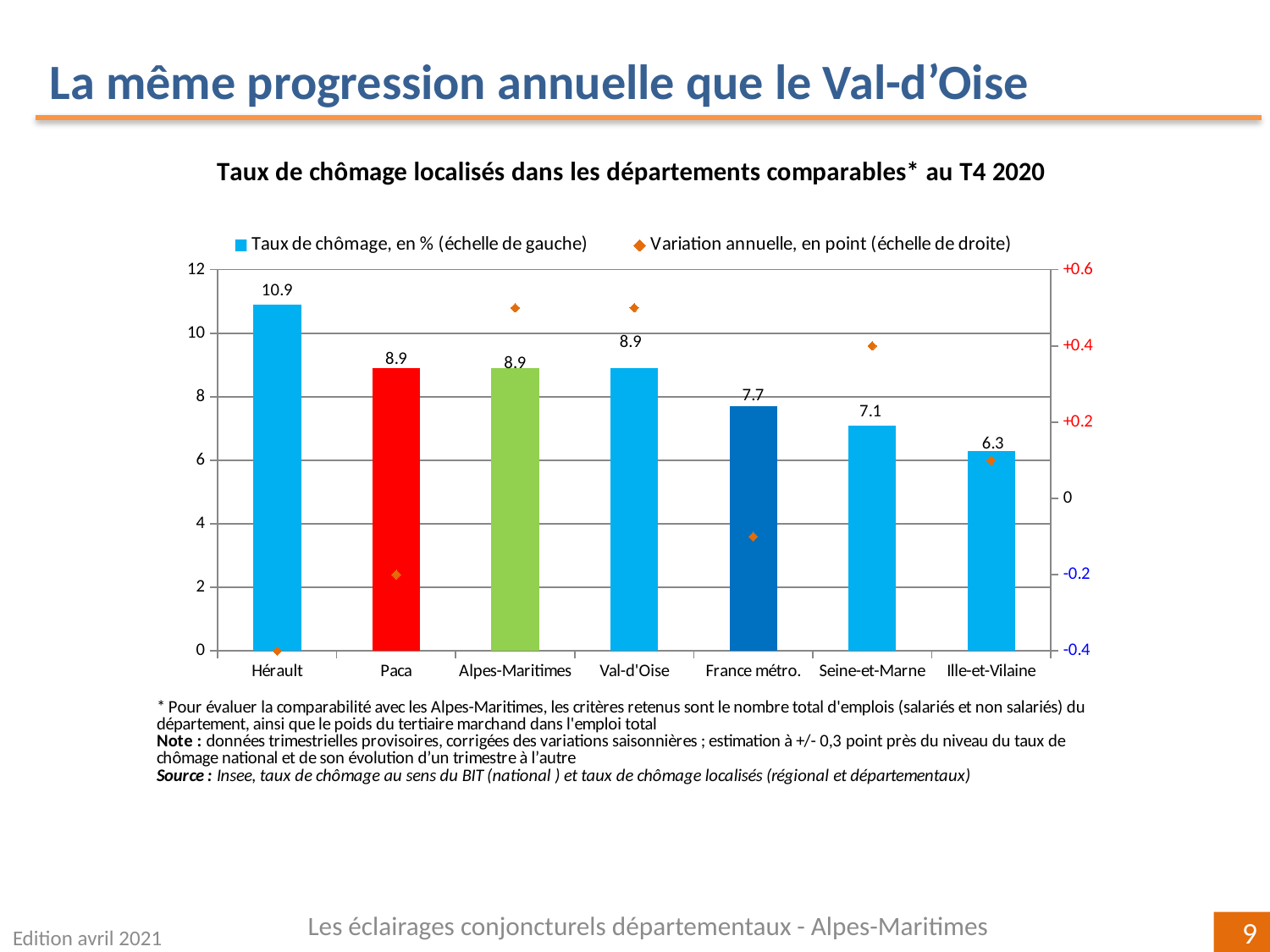
What is the unemployment rate (taux de chômage) shown for Hérault? 10.9 Is the annual variation for France métro. greater or less than 0? less Is the annual variation (Variation annuelle) for Alpes-Maritimes greater or less than +0.4? greater How many series does the chart legend list? 2 Which has the higher unemployment rate, France métro. or Seine-et-Marne? France métro. Which department or area has the lowest unemployment rate on the chart? Ille-et-Vilaine What is the difference between the unemployment rates of Hérault and Val-d'Oise? 2.0 What colour is the bar for Paca? Red Which department or area has the highest unemployment rate on the chart? Hérault What kind of chart is used to show the unemployment rates? Bar chart How many departments or areas are shown on the x axis of the chart? 7 What is the unemployment rate shown for Ille-et-Vilaine? 6.3